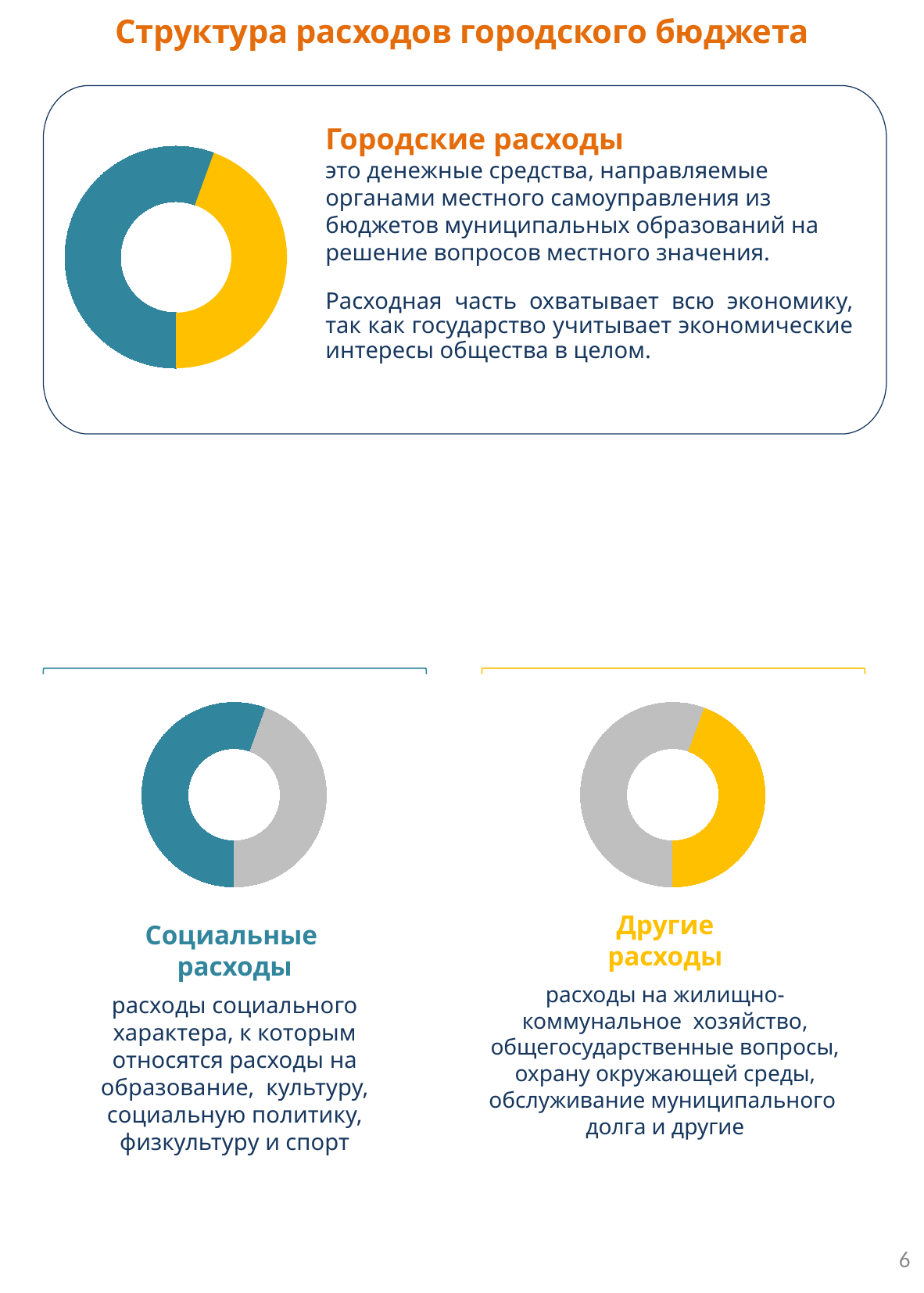
How many slices does the donut chart in the top box ("Городские расходы") have? 2 What kind of chart is shown above the label "Социальные расходы"? Donut (pie) chart How many donut charts are on the slide in total? 3 What kind of chart is shown in the top box next to the heading "Городские расходы"? Donut (pie) chart What colour is the highlighted slice in the donut chart above "Другие расходы"? Yellow How many slices does the donut chart above "Социальные расходы" have? 2 What two colours are used for the slices of the donut chart in the top box ("Городские расходы")? Teal and yellow What kind of chart is shown above the label "Другие расходы"? Donut (pie) chart In the donut chart in the top box ("Городские расходы"), which slice is larger, the teal one or the yellow one? The teal one